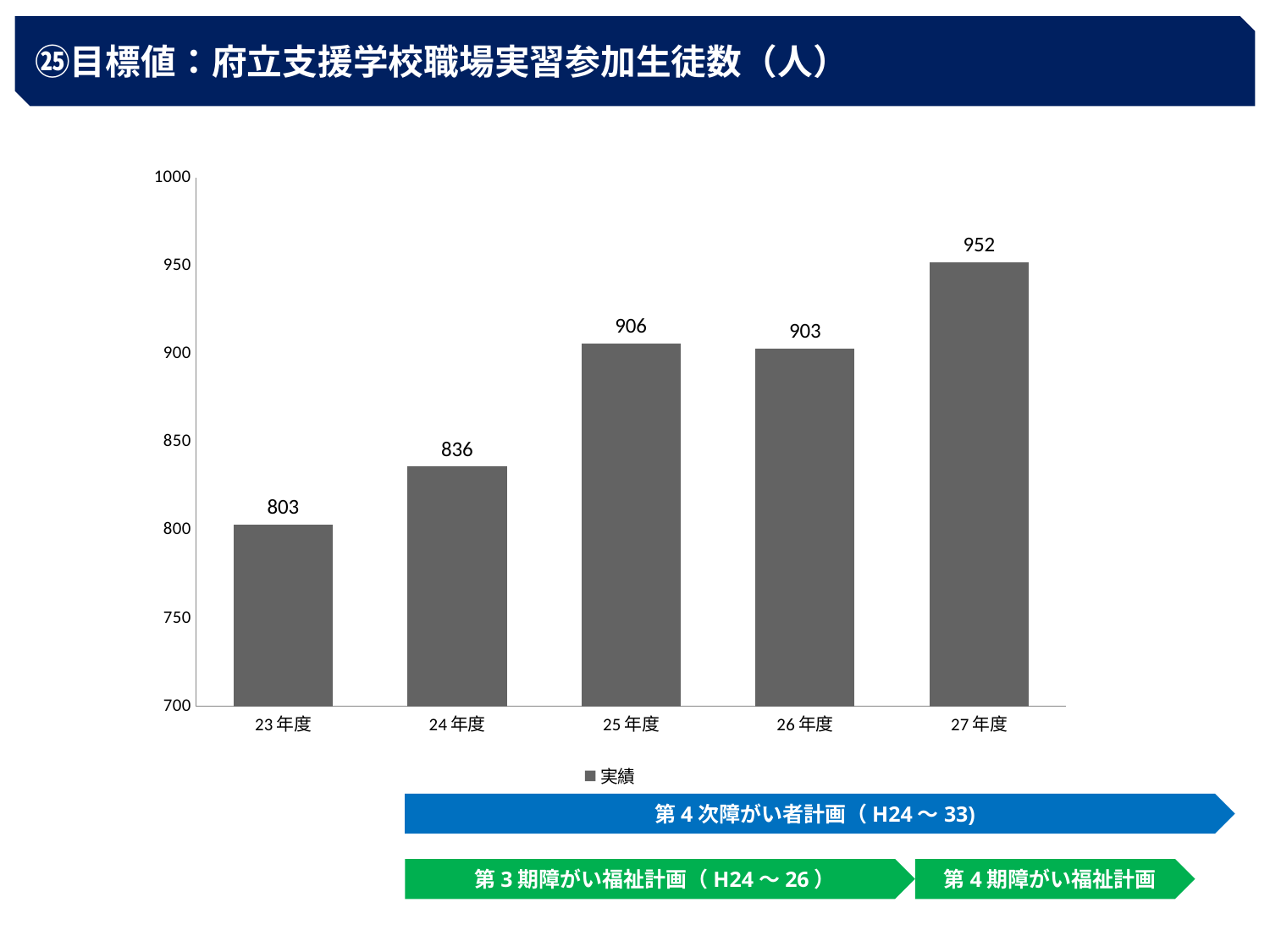
What kind of chart is shown on the slide? bar chart Is the value for 24年度 greater or less than 850? less What is the difference between the values for 24年度 and 23年度? 33 What series name does the legend show? 実績 What is the value for 25年度? 906 What is the difference between the values for 27年度 and 23年度? 149 How many years are shown on the x axis? 5 Which year has the lowest value? 23年度 Which year has the highest value? 27年度 What is the value for 23年度? 803 Which is larger, the value for 25年度 or 26年度? 25年度 What is the value for 27年度? 952